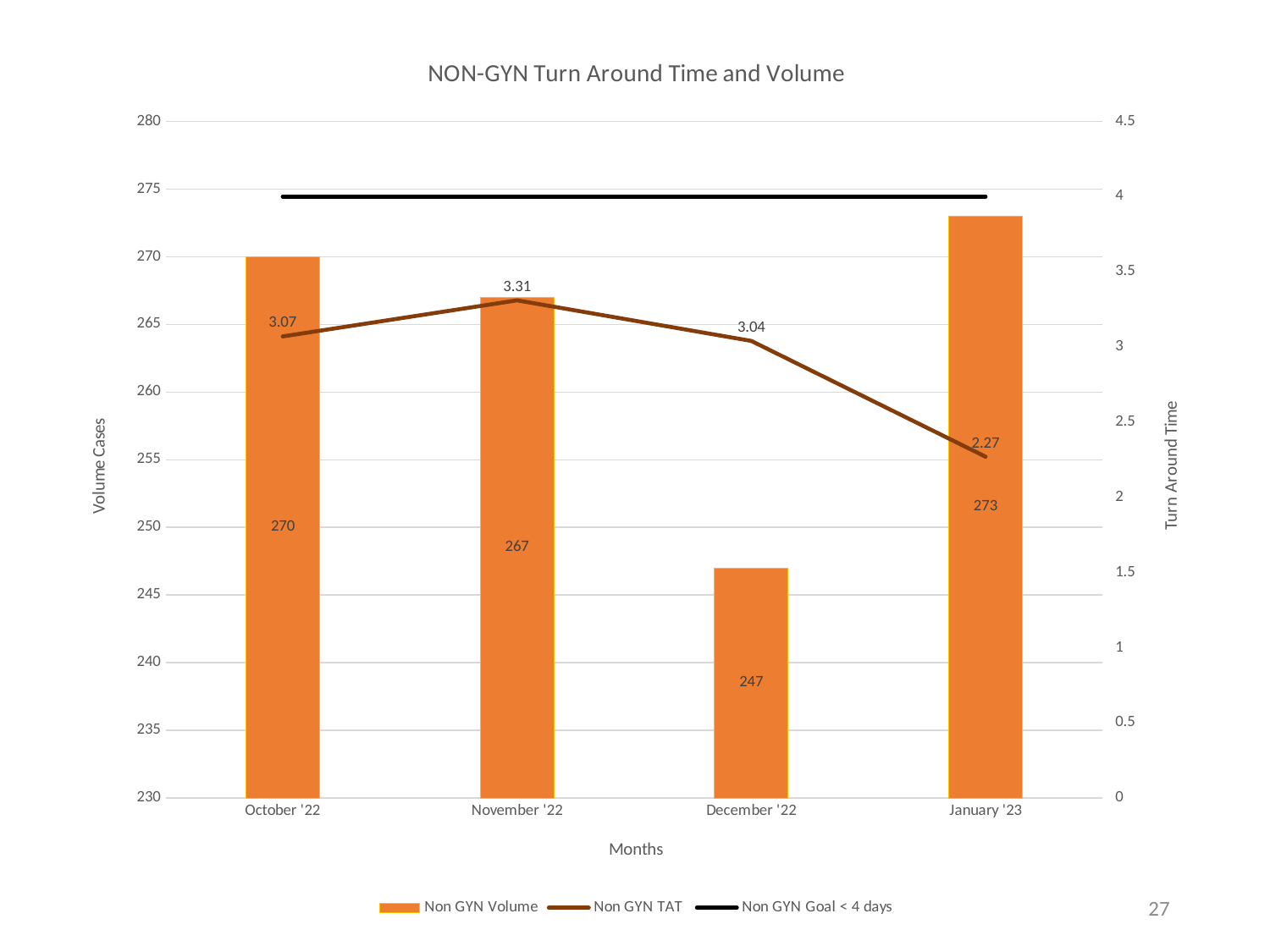
What is the Non GYN TAT for January '23? 2.27 What is the difference in Non GYN Volume between January '23 and December '22? 26 Does the Non GYN TAT rise or fall from November '22 to January '23? fall What is the Non GYN Volume for December '22? 247 Which month has the highest Non GYN Volume? January '23 Is the Non GYN TAT for December '22 greater or less than 4? less Which is larger, the Non GYN Volume for October '22 or November '22? October '22 What is the title of the chart? NON-GYN Turn Around Time and Volume Which month has the lowest Non GYN TAT? January '23 How many months are shown on the x axis? 4 How many series does the legend list? 3 What is the Non GYN TAT for November '22? 3.31